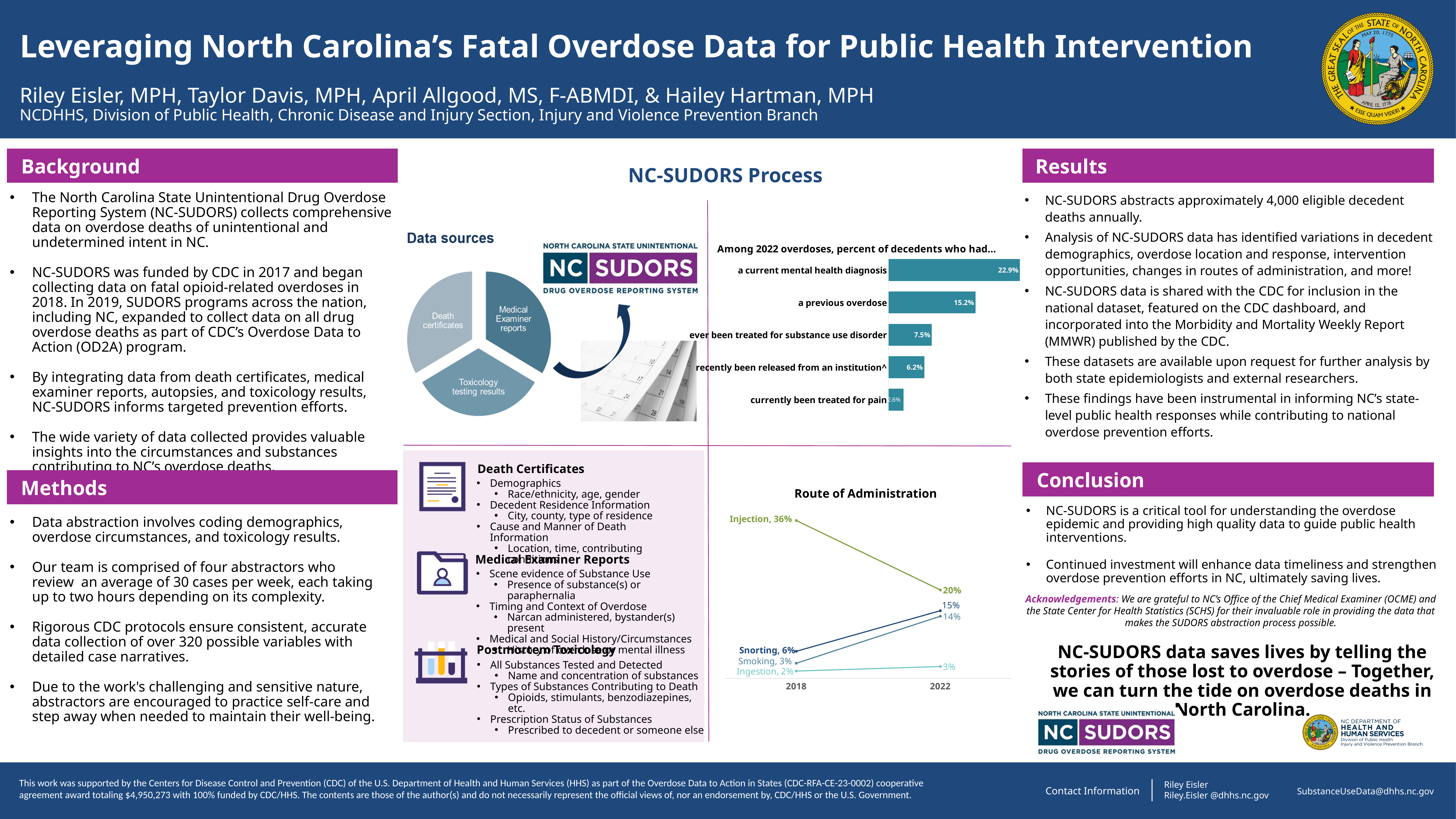
In the bar chart 'Among 2022 overdoses, percent of decedents who had...', what percent had a current mental health diagnosis? 22.9% How many categories are shown in the bar chart 'Among 2022 overdoses, percent of decedents who had...'? 5 In the bar chart 'Among 2022 overdoses, percent of decedents who had...', what percent had a previous overdose? 15.2% In the 'Route of Administration' chart, what was the value for Injection in 2022? 20% In the bar chart 'Among 2022 overdoses, percent of decedents who had...', what is the difference between the percent with a current mental health diagnosis and the percent with a previous overdose? 7.7% In the bar chart 'Among 2022 overdoses, percent of decedents who had...', what percent had ever been treated for substance use disorder? 7.5% In the bar chart 'Among 2022 overdoses, percent of decedents who had...', which category has the highest value? a current mental health diagnosis In the 'Route of Administration' chart, what was the value for Injection in 2018? 36% In the 'Route of Administration' chart, does the Injection line rise or fall from 2018 to 2022? fall What type of chart is 'Among 2022 overdoses, percent of decedents who had...'? bar chart In the bar chart 'Among 2022 overdoses, percent of decedents who had...', which category has the lowest value? currently been treated for pain What type of chart is 'Route of Administration'? line chart